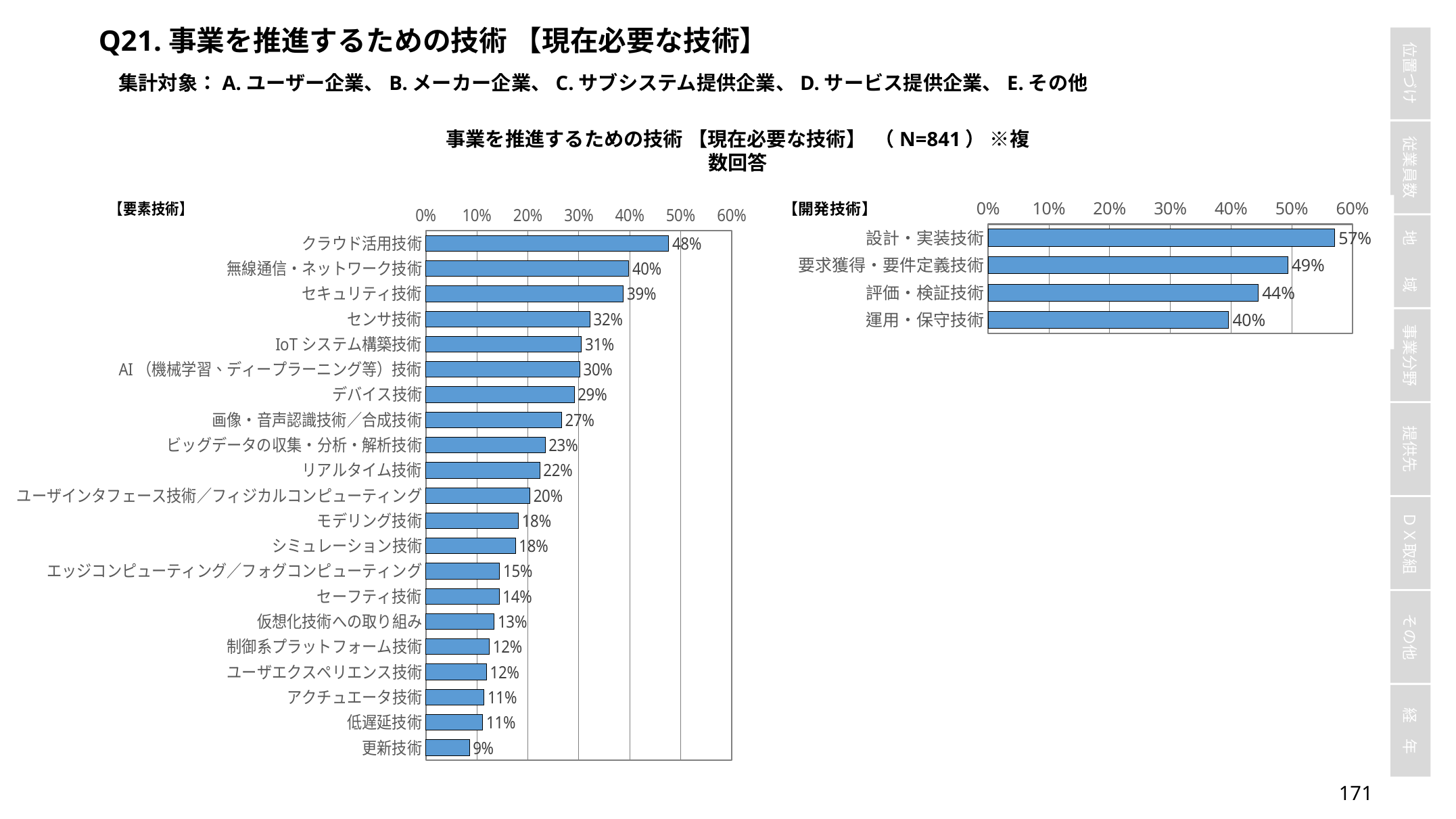
In the 【開発技術】 chart, what is the value for 評価・検証技術? 44% In the 【要素技術】 chart, which category has the lowest value? 更新技術 In the 【要素技術】 chart, which is larger: セキュリティ技術 or デバイス技術? セキュリティ技術 In the 【要素技術】 chart, which category has the highest value? クラウド活用技術 In the 【要素技術】 chart, what is the difference between センサ技術 and ビッグデータの収集・分析・解析技術? 9% In the 【開発技術】 chart, what is the difference between 設計・実装技術 and 運用・保守技術? 17% How many categories are shown in the 【要素技術】 chart? 21 What kind of chart is the 【要素技術】 chart? Bar chart In the 【要素技術】 chart, what is the value for クラウド活用技術? 48% In the 【開発技術】 chart, which category has the highest value? 設計・実装技術 How many categories are shown in the 【開発技術】 chart? 4 In the 【要素技術】 chart, is the value for 無線通信・ネットワーク技術 greater or less than 30%? greater